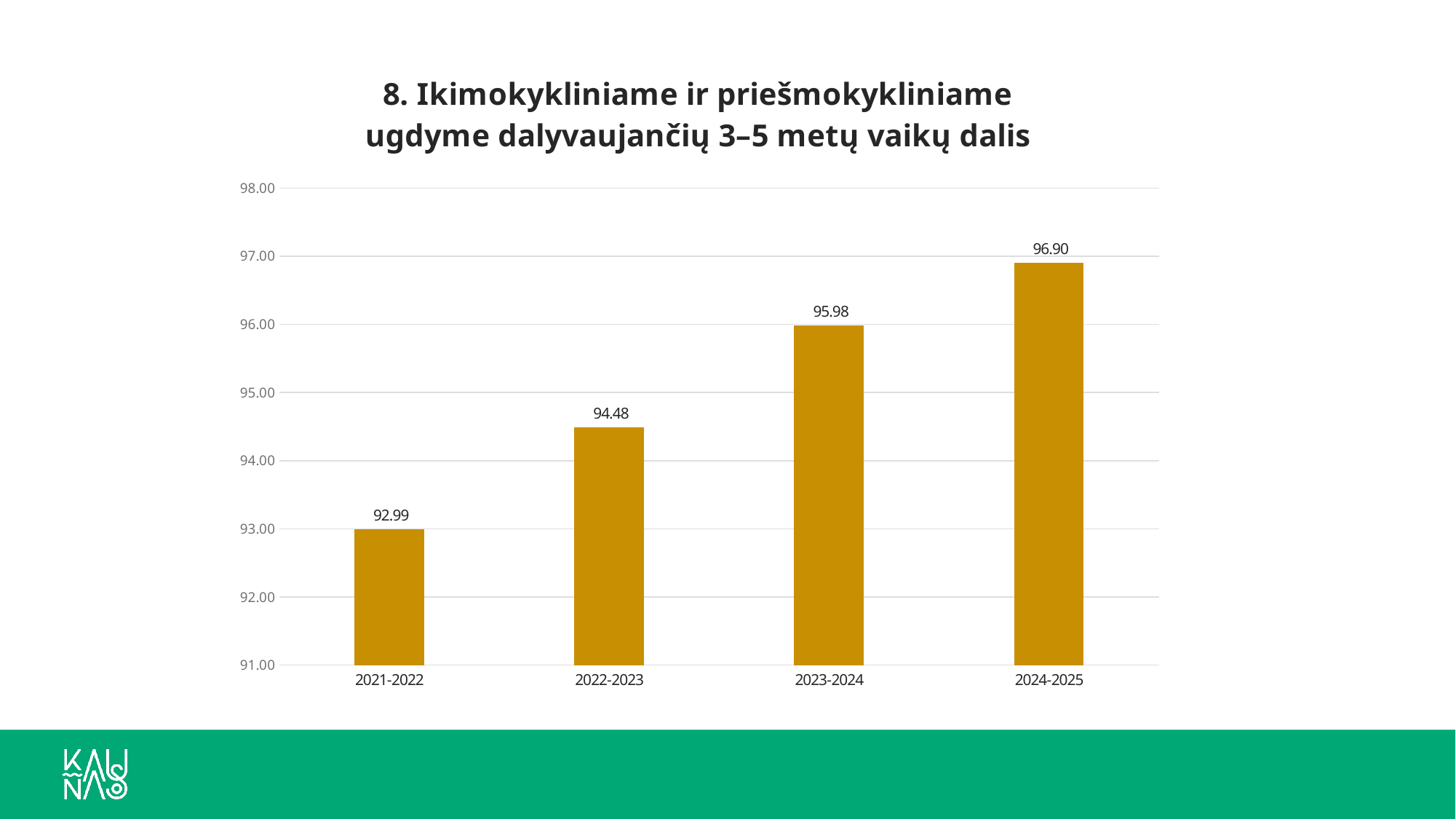
What is the value for 2021-2022? 92.99 What is the value for 2023-2024? 95.98 What is the value for 2022-2023? 94.48 Do the values rise or fall from 2021-2022 to 2024-2025? Rise What kind of chart is shown on the slide? Bar chart Which school year has the lowest value? 2021-2022 How many school years are shown on the chart? 4 Which school year has the highest value? 2024-2025 Which is larger, the value for 2022-2023 or the value for 2023-2024? 2023-2024 What is the difference between the values for 2023-2024 and 2022-2023? 1.50 What is the value for 2024-2025? 96.90 What is the difference between the values for 2024-2025 and 2021-2022? 3.91